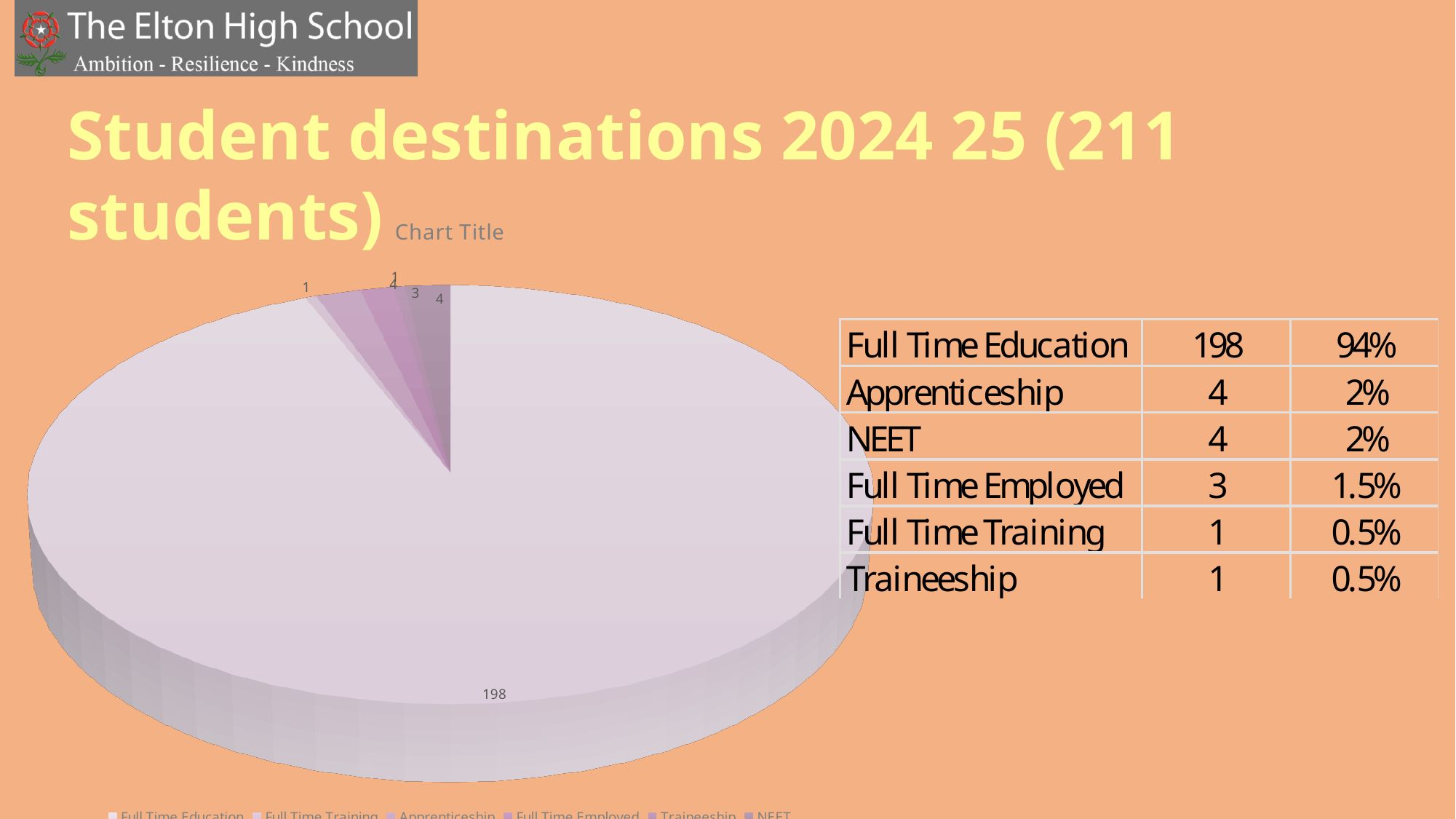
Which is larger, the value for Apprenticeship or the value for Full Time Employed? Apprenticeship What percentage of students went into Full Time Education? 94% How many students went into Full Time Education? 198 Which two destinations have the smallest value, with 1 student each? Full Time Training and Traineeship How many destination categories does the pie chart legend list? 6 How many students are recorded as NEET? 4 What percentage of students took an Apprenticeship? 2% What title is displayed above the pie chart? Chart Title What kind of chart is shown on the slide? pie chart Which destination has the largest slice of the pie? Full Time Education How many students went into Full Time Employed? 3 What is the difference between the number of students in Full Time Education and the number in Apprenticeship? 194